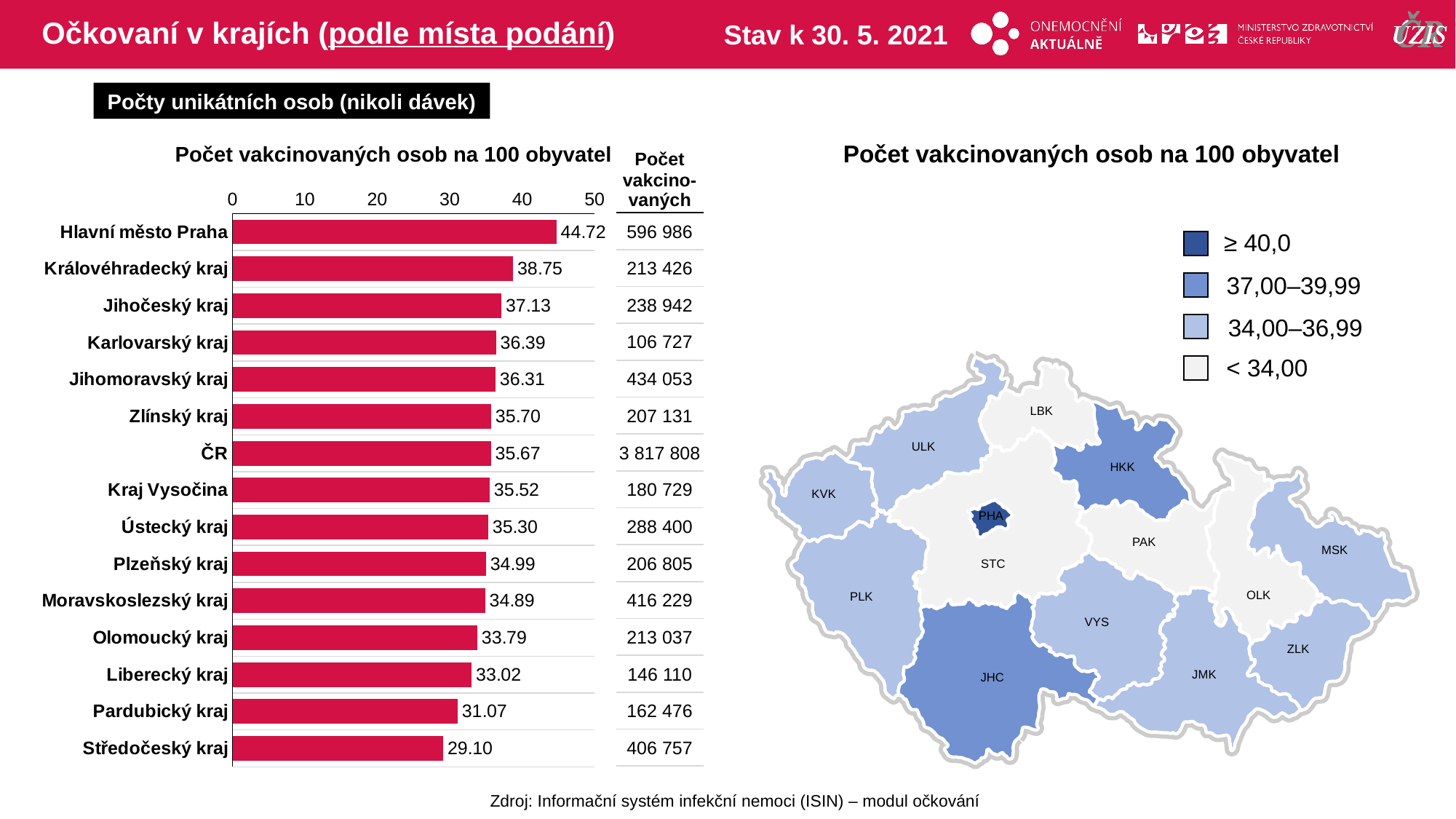
In the bar chart, what is the value for Jihomoravský kraj? 36.31 In the bar chart, which category has the highest value? Hlavní město Praha What kind of chart is used on the left side of the slide? bar chart In the bar chart, is the value for Středočeský kraj greater or less than 30? less What is the title of the bar chart on the left? Počet vakcinovaných osob na 100 obyvatel How many categories (bars) does the bar chart show? 15 In the bar chart, is the value for Hlavní město Praha greater or less than 40? greater In the bar chart, what is the difference between the values for Hlavní město Praha and Středočeský kraj? 15.62 In the bar chart, which category has the lowest value? Středočeský kraj In the bar chart, what is the value for Hlavní město Praha? 44.72 In the bar chart, which is larger: the value for Královéhradecký kraj or Jihočeský kraj? Královéhradecký kraj In the bar chart, what is the value for ČR? 35.67